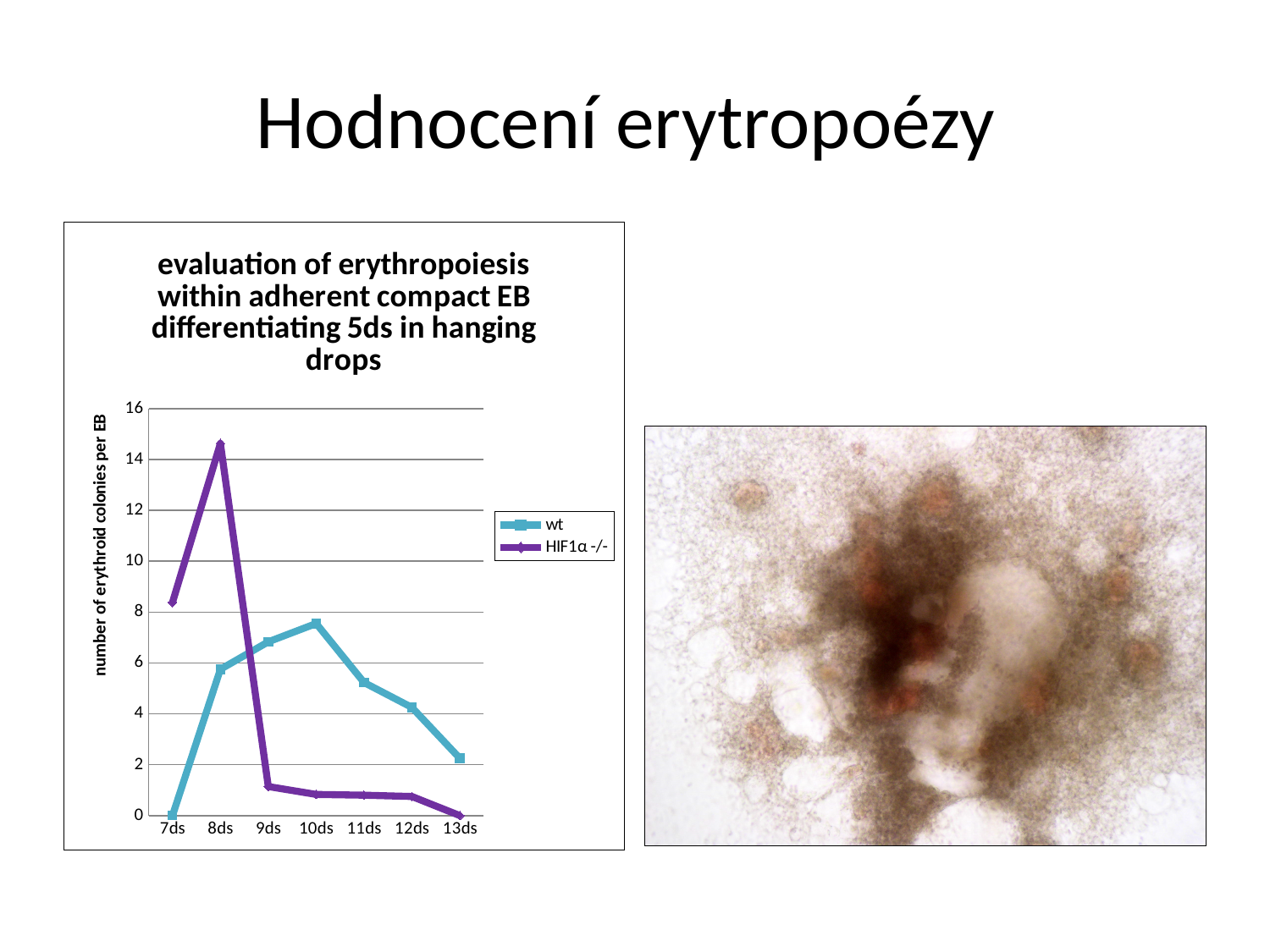
Is the value for wt at 10ds greater or less than 8? less Is the value for HIF1α -/- at 8ds greater or less than 14? greater What is the label of the y axis? number of erythroid colonies per EB Is the value for HIF1α -/- at 7ds greater or less than 8? greater At which time point does the HIF1α -/- series reach its highest value? 8ds At which time point does the wt series reach its highest value? 10ds How many time points are plotted along the x axis? 7 How many series does the legend list? 2 Which series has the larger value at 7ds, wt or HIF1α -/-? HIF1α -/- Which series has the larger value at 11ds, wt or HIF1α -/-? wt Does the wt series rise or fall from 10ds to 13ds? fall What kind of chart is shown on the slide? line chart